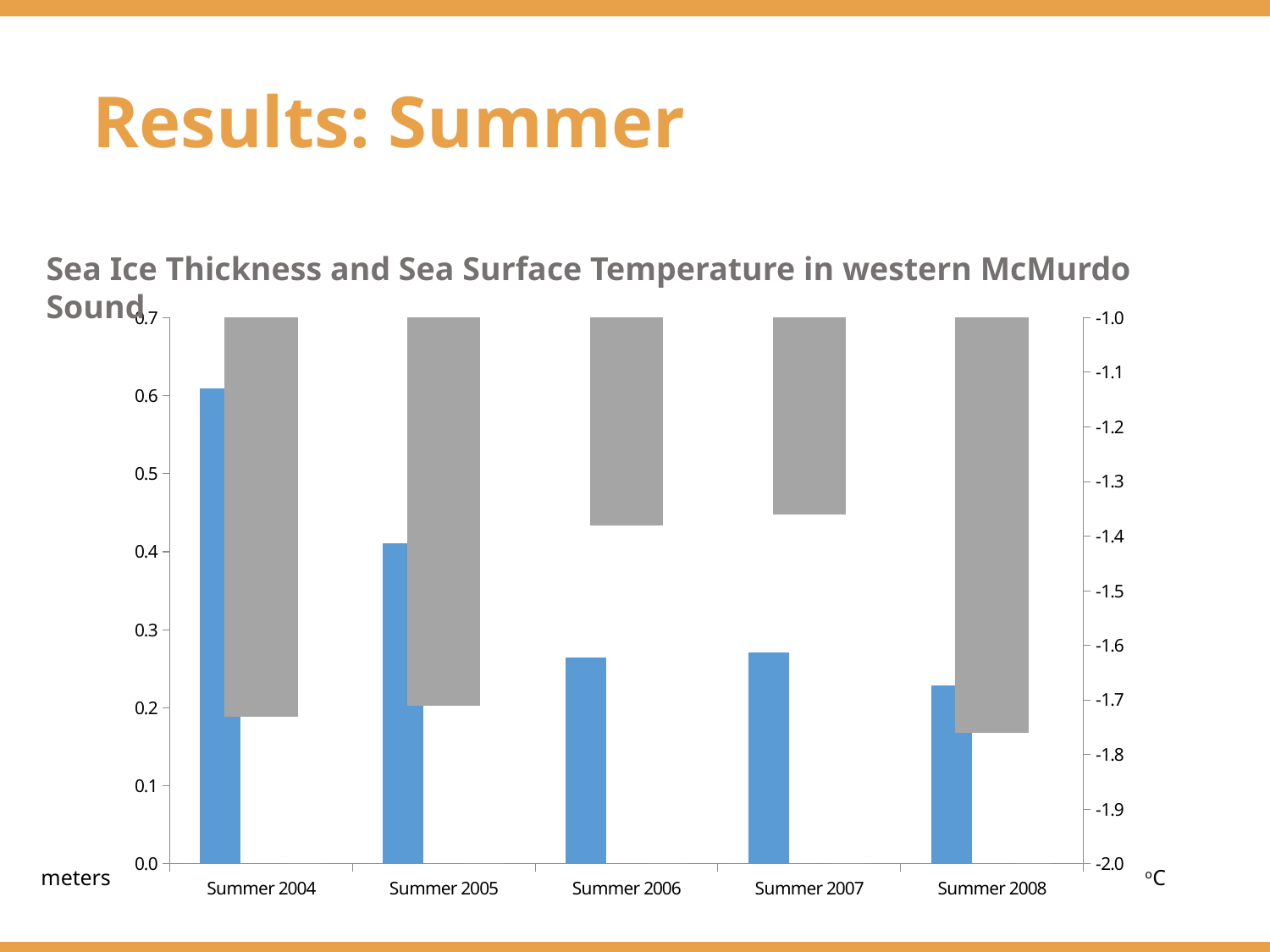
Which has the taller blue bar, Summer 2004 or Summer 2005? Summer 2004 Is the blue bar for Summer 2004 greater or less than 0.5 on the left axis? greater What kind of chart is shown on the slide? bar chart Is the blue bar for Summer 2005 greater or less than 0.5 on the left axis? less Do the blue bars generally rise or fall from Summer 2004 to Summer 2008? fall What is the title of the chart? Sea Ice Thickness and Sea Surface Temperature in western McMurdo Sound Which summer has the tallest blue bar? Summer 2004 Is the blue bar for Summer 2008 greater or less than 0.2 on the left axis? greater Which summer has the shortest blue bar? Summer 2008 What unit is shown for the left axis of the chart? meters How many summer categories are shown on the x axis? 5